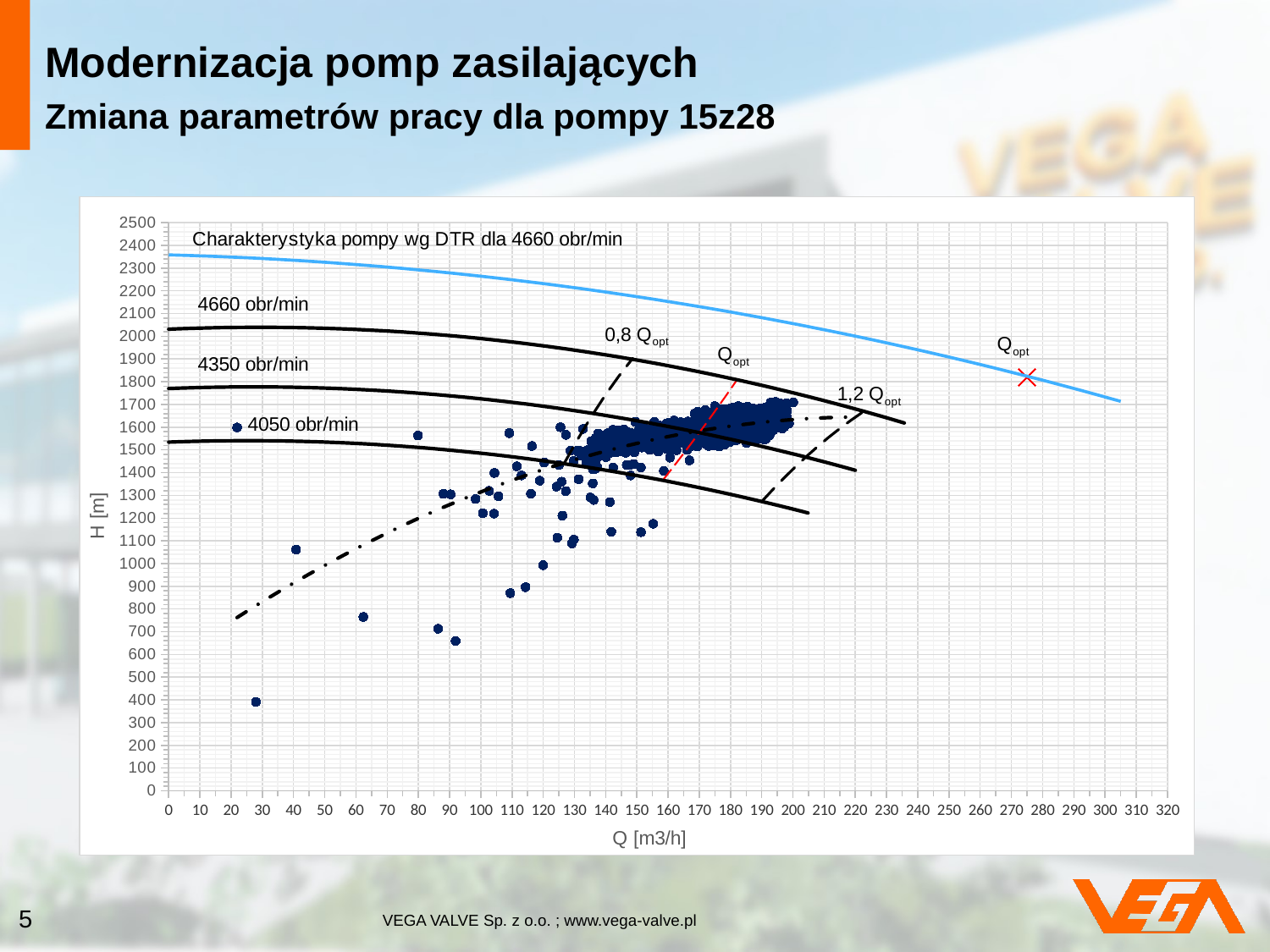
At Q = 100, which curve is higher: the blue DTR curve or the 4660 obr/min black curve? the blue DTR curve What is the highest value shown on the y axis? 2500 Is the value of the 4660 obr/min black curve at Q = 0 greater or less than 2100? less Is the value of the 4050 obr/min curve at Q = 0 greater or less than 1500? greater Is the value of the blue DTR curve at Q = 300 greater or less than 1800? less What is the label of the x axis? Q [m3/h] What is the highest value shown on the x axis? 320 What is the label of the y axis? H [m] How many rotational speeds (obr/min) are labelled on the black curves? 3 Does the blue DTR curve rise or fall as Q increases? fall What kind of chart is shown on the slide? scatter chart